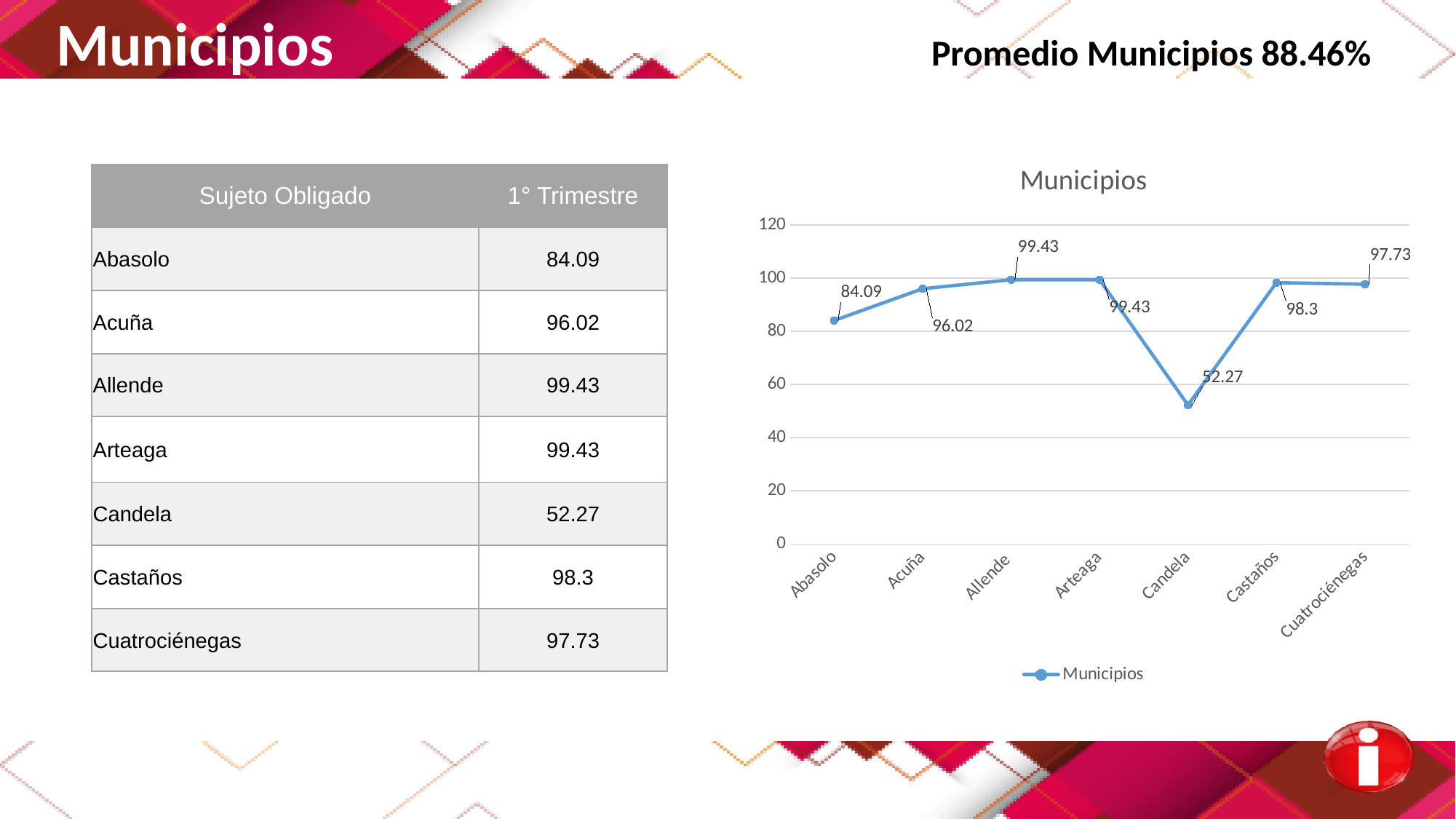
What is the value for Abasolo in the Municipios chart? 84.09 Which municipality has the lowest value in the Municipios chart? Candela Which is larger in the Municipios chart, the value for Acuña or the value for Abasolo? Acuña What is the value for Cuatrociénegas in the Municipios chart? 97.73 Is the value for Candela in the Municipios chart greater or less than 60? less What kind of chart is the Municipios chart? line chart What is the difference between the values for Castaños and Candela in the Municipios chart? 46.03 What is the value for Castaños in the Municipios chart? 98.3 What is the value for Candela in the Municipios chart? 52.27 What is the difference between the values for Acuña and Abasolo in the Municipios chart? 11.93 How many municipalities are plotted in the Municipios chart? 7 How many series does the legend of the Municipios chart list? 1